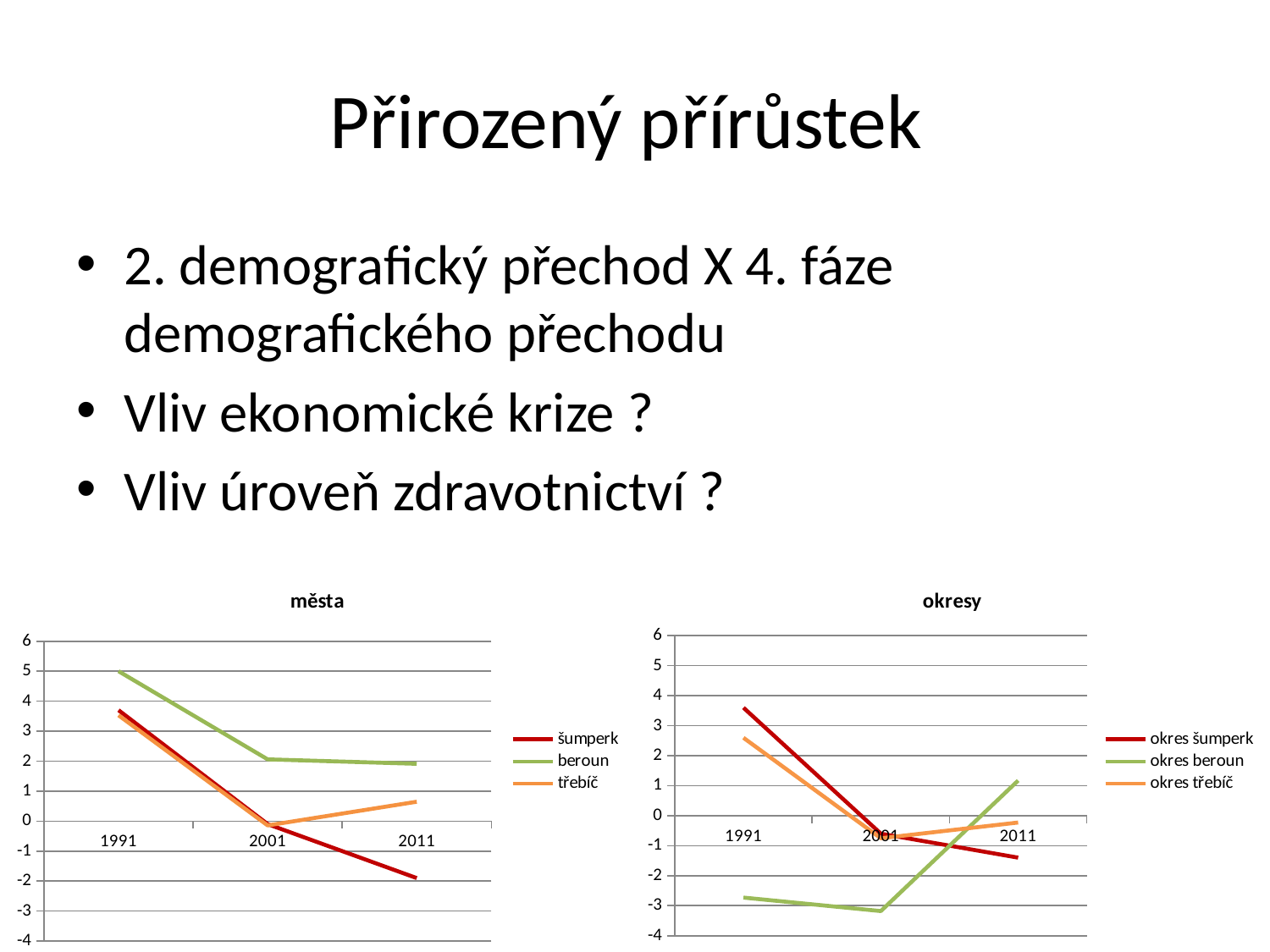
In the chart titled "okresy", is the value for okres šumperk in 1991 greater or less than 3? greater In the chart titled "okresy", does the okres šumperk line rise or fall from 1991 to 2011? fall In the chart titled "města", is the value for beroun in 1991 greater or less than 4? greater In the chart titled "města", what kind of chart is shown? line chart In the chart titled "města", which series has the highest value in 1991? beroun In the chart titled "okresy", which series has the lowest value in 2001? okres beroun In the chart titled "okresy", which series has the highest value in 2011? okres beroun In the chart titled "města", how many series does the legend list? 3 In the chart titled "města", how many years are shown on the x axis? 3 In the chart titled "města", which series has the lowest value in 2011? šumperk In the chart titled "města", does the šumperk line rise or fall from 1991 to 2011? fall In the chart titled "okresy", which series is drawn in green? okres beroun